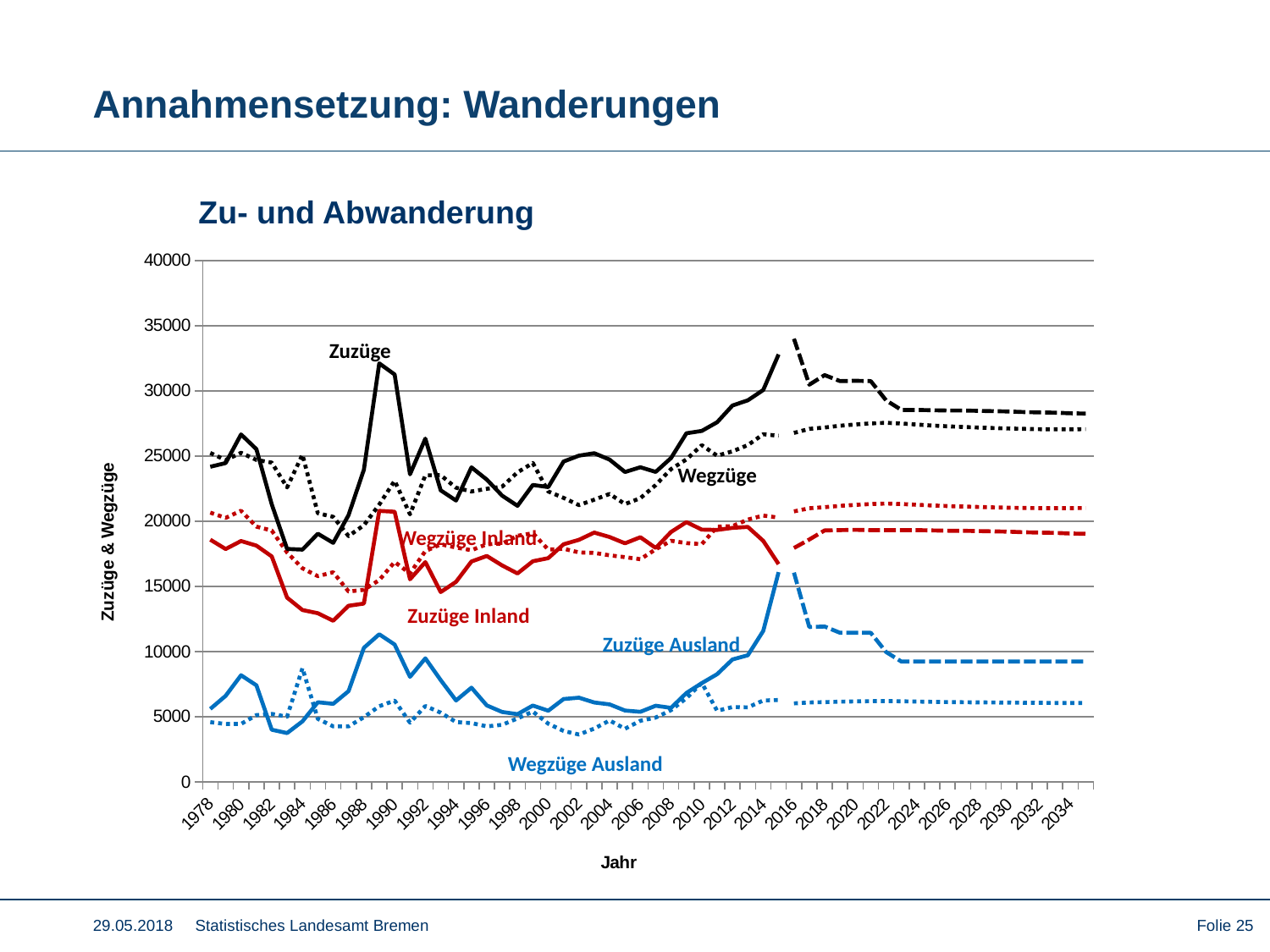
Is the value for Zuzüge in 2015 greater or less than 30000? greater In 1990, which is larger: Zuzüge Inland or Zuzüge Ausland? Zuzüge Inland Does the Zuzüge Ausland series rise or fall between 2008 and 2015? rise Is the value for Zuzüge Inland in 1986 greater or less than 15000? less Which series has the lowest values on the chart? Wegzüge Ausland What kind of chart is shown on the slide? line chart How many series are labelled on the chart? 6 Which series reaches the highest values on the chart? Zuzüge What is the label of the x axis? Jahr What is the title of the chart? Zu- und Abwanderung In 2015, which is larger: Zuzüge or Wegzüge? Zuzüge